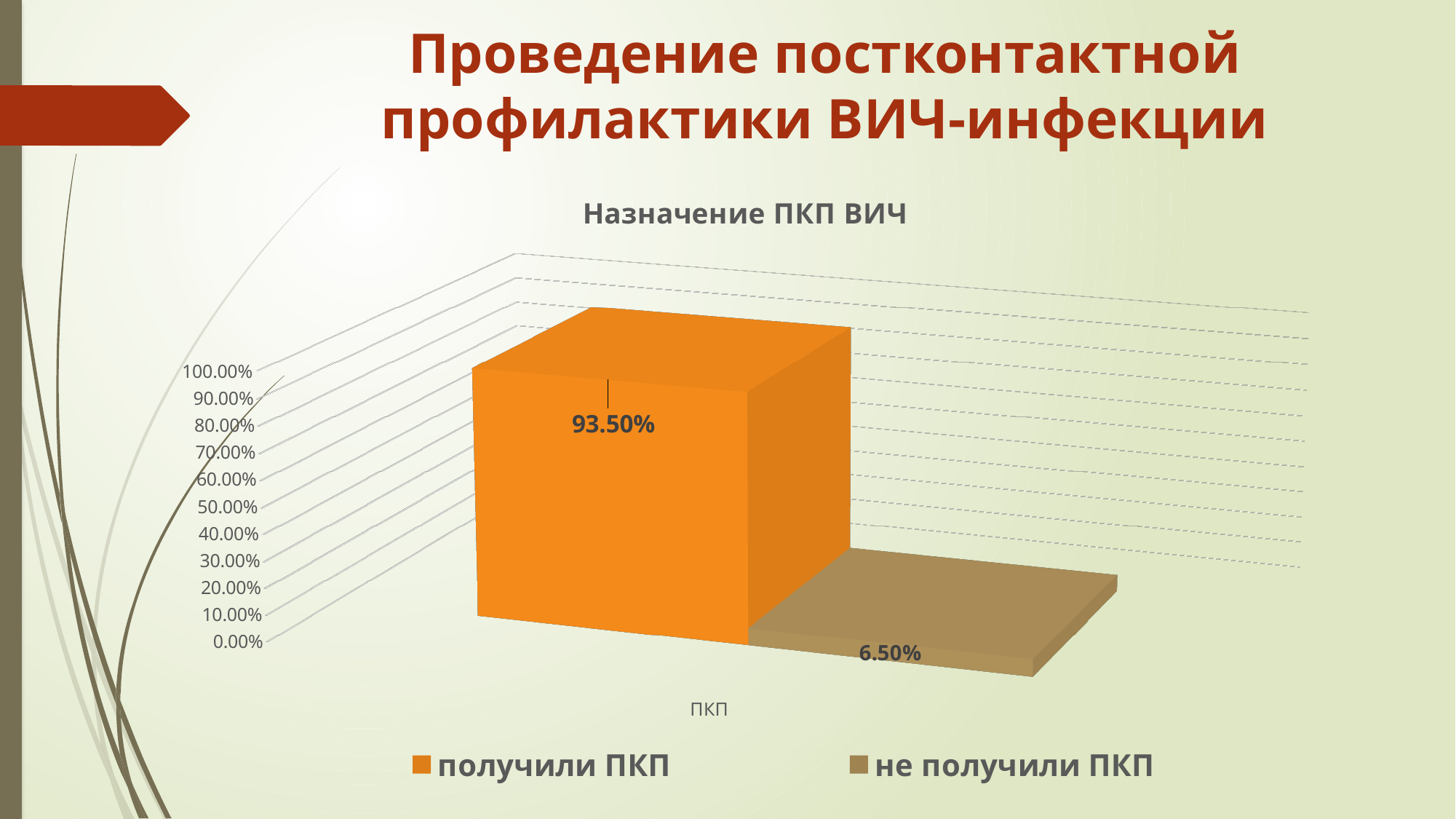
What kind of chart is shown on the slide? bar chart Is the value for 'не получили ПКП' greater or less than 10.00%? less Which series has the lowest value in the chart? не получили ПКП What colour represents the 'получили ПКП' series in the chart? orange Which is larger: the value for 'получили ПКП' or for 'не получили ПКП'? получили ПКП What is the value for 'не получили ПКП' in the chart? 6.50% What is the value for 'получили ПКП' in the chart? 93.50% What is the difference between the values for 'получили ПКП' and 'не получили ПКП'? 87.00% Which series has the highest value in the chart? получили ПКП What is the title of the chart? Назначение ПКП ВИЧ Is the value for 'получили ПКП' greater or less than 90.00%? greater How many series does the legend list? 2